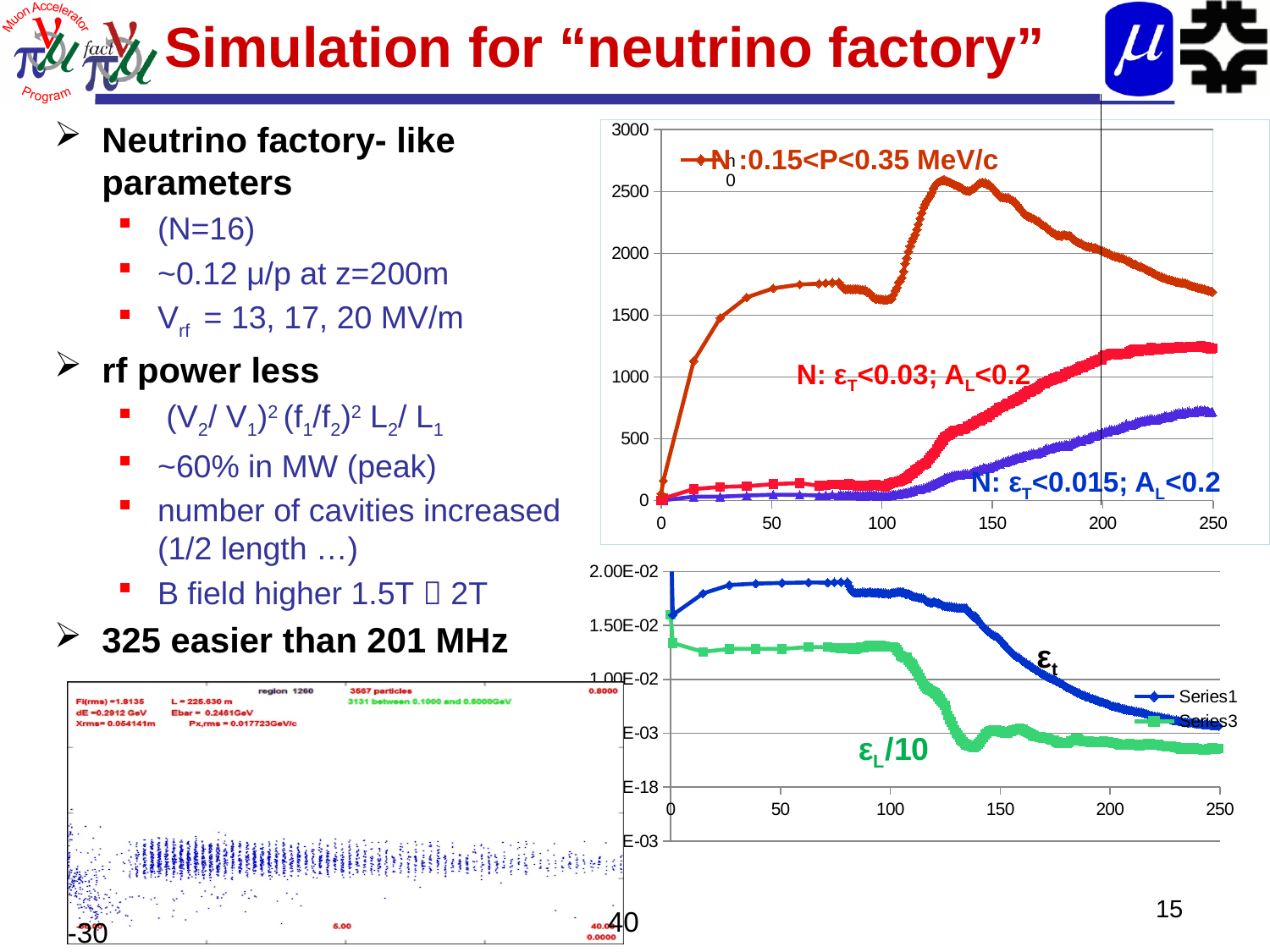
In the bottom chart, at x=50, which series has the larger value: Series1 or Series3? Series1 What kind of chart is the top chart on the slide? line chart In the top chart, does the blue 'N: εT<0.015; AL<0.2' line generally rise or fall from x=100 to x=250? rise In the bottom chart, how many series does the legend list? 2 In the bottom chart, what are the names of the series listed in the legend? Series1 and Series3 In the top chart, is the value of the blue 'N: εT<0.015; AL<0.2' line at x=250 greater or less than 1000? less In the bottom chart, does Series1 rise or fall from x=100 to x=250? fall In the top chart, is the value of the orange 'N: 0.15<P<0.35 MeV/c' line at x=250 greater or less than 1500? greater What kind of chart is the bottom chart on the slide? line chart In the top chart, at x=250, which line has the larger value: the orange 'N: 0.15<P<0.35 MeV/c' line or the blue 'N: εT<0.015; AL<0.2' line? the orange 'N: 0.15<P<0.35 MeV/c' line In the top chart, how many lines are plotted? 3 In the top chart, is the value of the red 'N: εT<0.03; AL<0.2' line at x=250 greater or less than 1000? greater